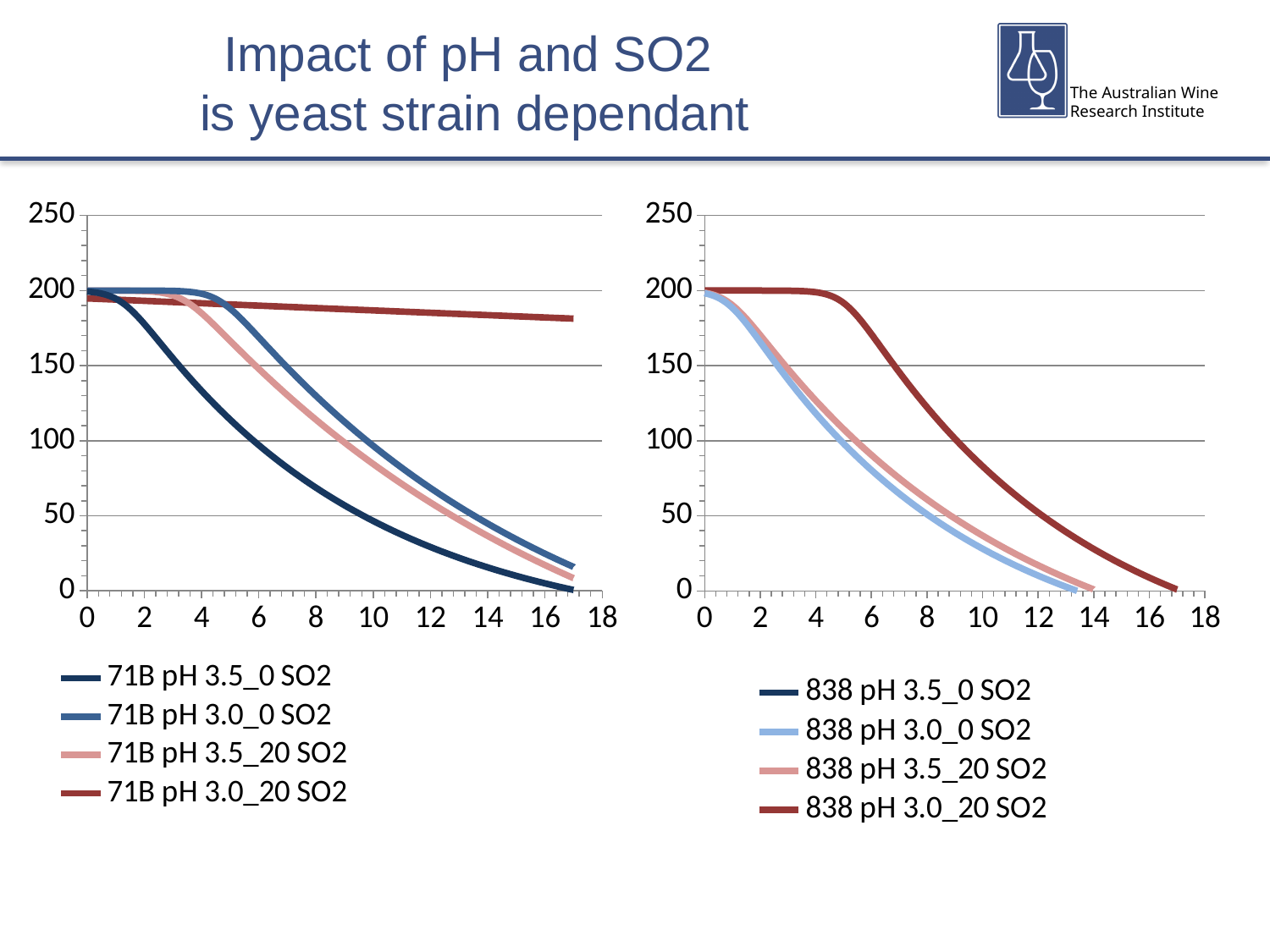
In the left chart, at x = 10, which series has the larger value: 71B pH 3.0_20 SO2 or 71B pH 3.5_0 SO2? 71B pH 3.0_20 SO2 In the right chart, does the 838 pH 3.0_20 SO2 line rise or fall as the x axis increases? fall How many series does the legend of the left chart list? 4 In the left chart, does the 71B pH 3.5_0 SO2 line rise or fall as the x axis increases? fall What kind of chart is the left chart on the slide? line chart In the right chart, is the value of 838 pH 3.0_20 SO2 at x = 8 greater or less than 100? greater In the left chart, is the value of 71B pH 3.5_0 SO2 at x = 8 greater or less than 100? less How many series does the legend of the right chart list? 4 What kind of chart is the right chart on the slide? line chart In the right chart, at x = 10, which series has the larger value: 838 pH 3.0_20 SO2 or 838 pH 3.0_0 SO2? 838 pH 3.0_20 SO2 In the left chart, is the value of 71B pH 3.0_20 SO2 at x = 16 greater or less than 150? greater